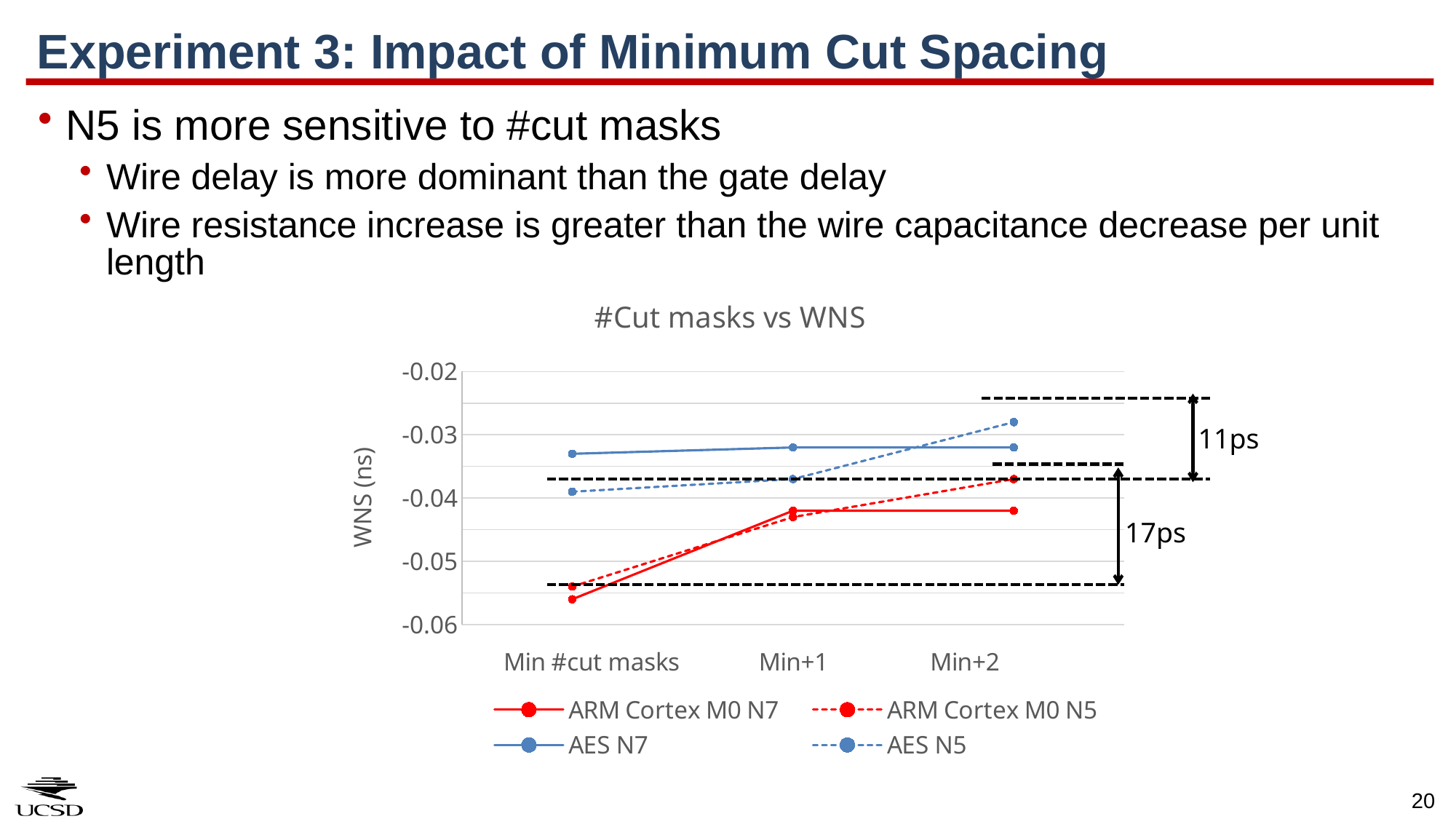
At Min #cut masks, which series has the higher WNS value: AES N7 or AES N5? AES N7 How many series does the legend of the '#Cut masks vs WNS' chart list? 4 Is the value for AES N5 at Min #cut masks greater or less than -0.03? less At Min+2, which series has the higher WNS value: AES N5 or AES N7? AES N5 Is the value for ARM Cortex M0 N7 at Min #cut masks greater or less than -0.05? less Which series has the highest WNS value at Min+2? AES N5 Do the values for AES N5 rise or fall from Min #cut masks to Min+2? rise Is the value for ARM Cortex M0 N5 at Min+2 greater or less than -0.04? greater What are the two WNS differences annotated with arrows on the right side of the chart? 11ps and 17ps What kind of chart is shown on the slide? line chart How many categories are shown on the x axis of the chart? 3 What is the title of the chart? #Cut masks vs WNS